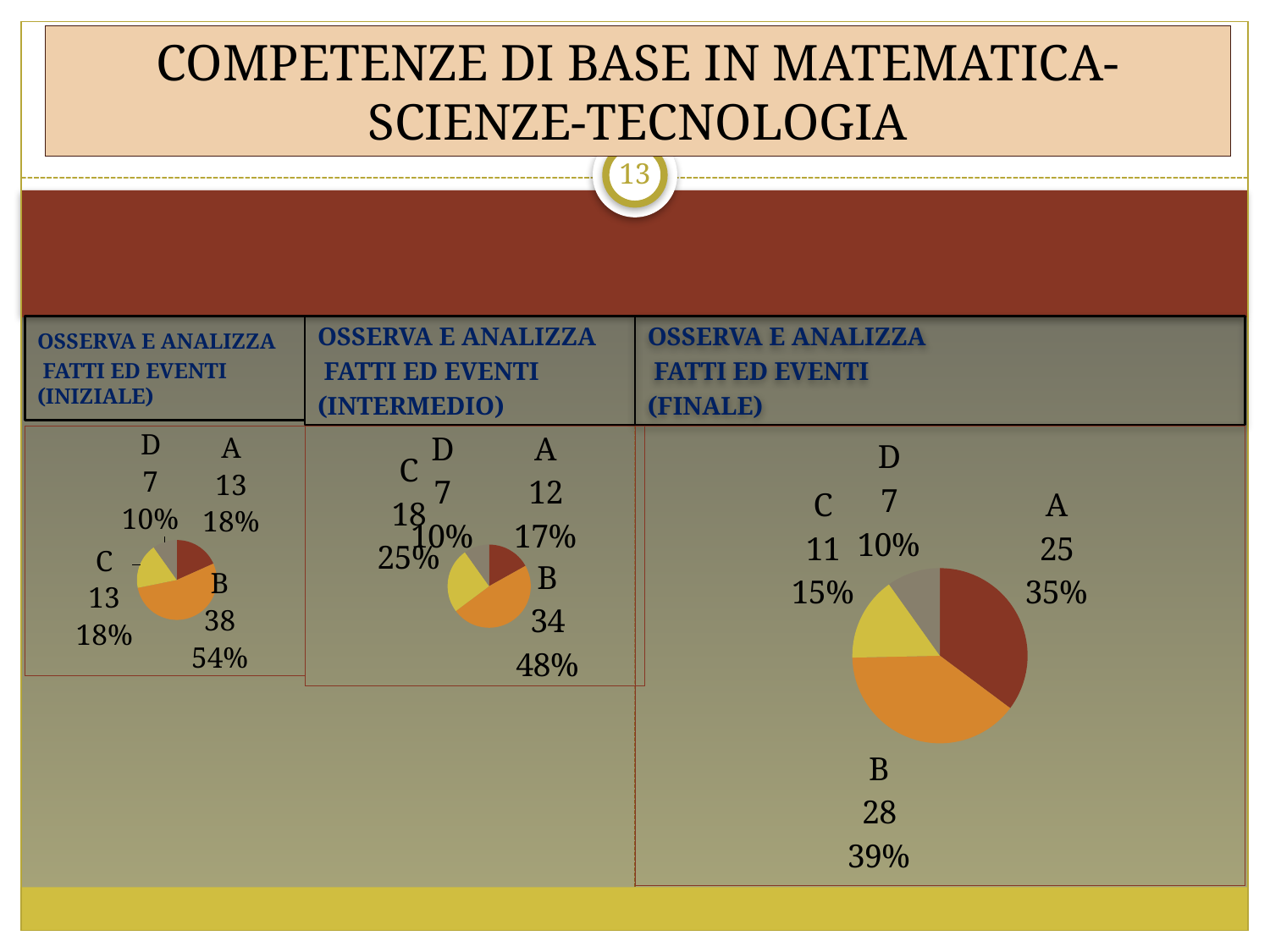
In the INIZIALE pie chart, what percentage share does category B have? 54% In the FINALE pie chart, which is larger, the value for C or the value for D? C In the INTERMEDIO pie chart, what value is shown for category C? 18 How many categories does the FINALE pie chart show? 4 In the INTERMEDIO pie chart, what percentage share does category A have? 17% In the FINALE pie chart, what is the difference between the values for B and A? 3 What kind of chart is used in the INIZIALE panel? Pie chart In the FINALE pie chart, what value is shown for category A? 25 In the FINALE pie chart, what percentage share does category B have? 39% In the INIZIALE pie chart, what value is shown for category B? 38 In the INTERMEDIO pie chart, which category has the highest value? B In the INIZIALE pie chart, which category has the lowest value? D